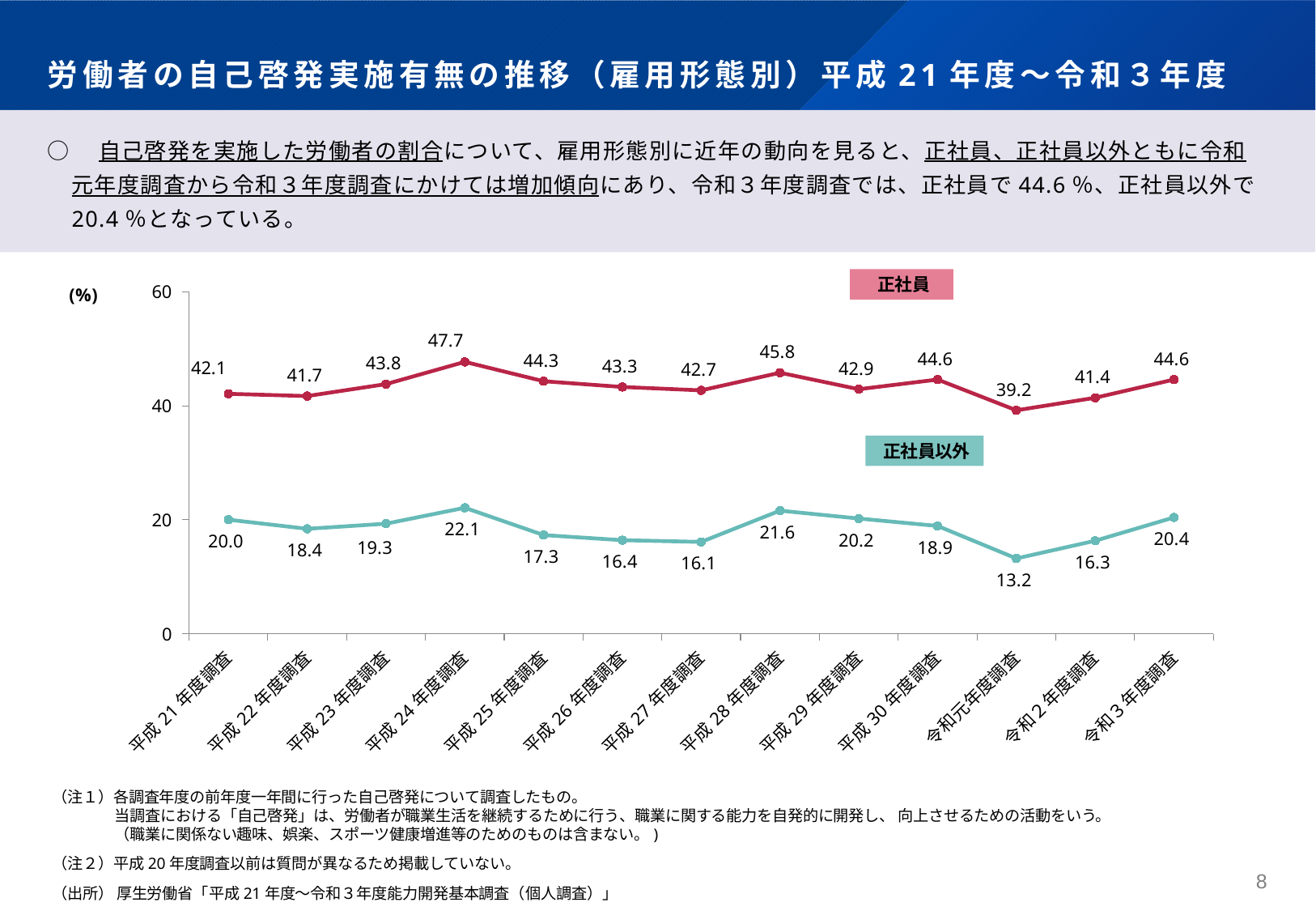
In which survey year is the 正社員 value highest? 平成24年度調査 What is the difference between the 正社員 and 正社員以外 values in the 令和3年度調査? 24.2 How many series are shown in the chart? 2 In which survey year is the 正社員以外 value lowest? 令和元年度調査 How many survey years are plotted on the x axis? 13 What kind of chart is shown on the slide? line chart From the 令和元年度調査 to the 令和3年度調査, does the 正社員以外 value rise or fall? rise Is the 正社員 value in the 令和元年度調査 greater or less than 40? less Which is larger: the 正社員以外 value in 平成28年度調査 or in 平成29年度調査? 平成28年度調査 What is the value for 正社員以外 in the 令和元年度調査? 13.2 What unit is shown on the y axis of the chart? % What is the value for 正社員 in the 平成24年度調査? 47.7